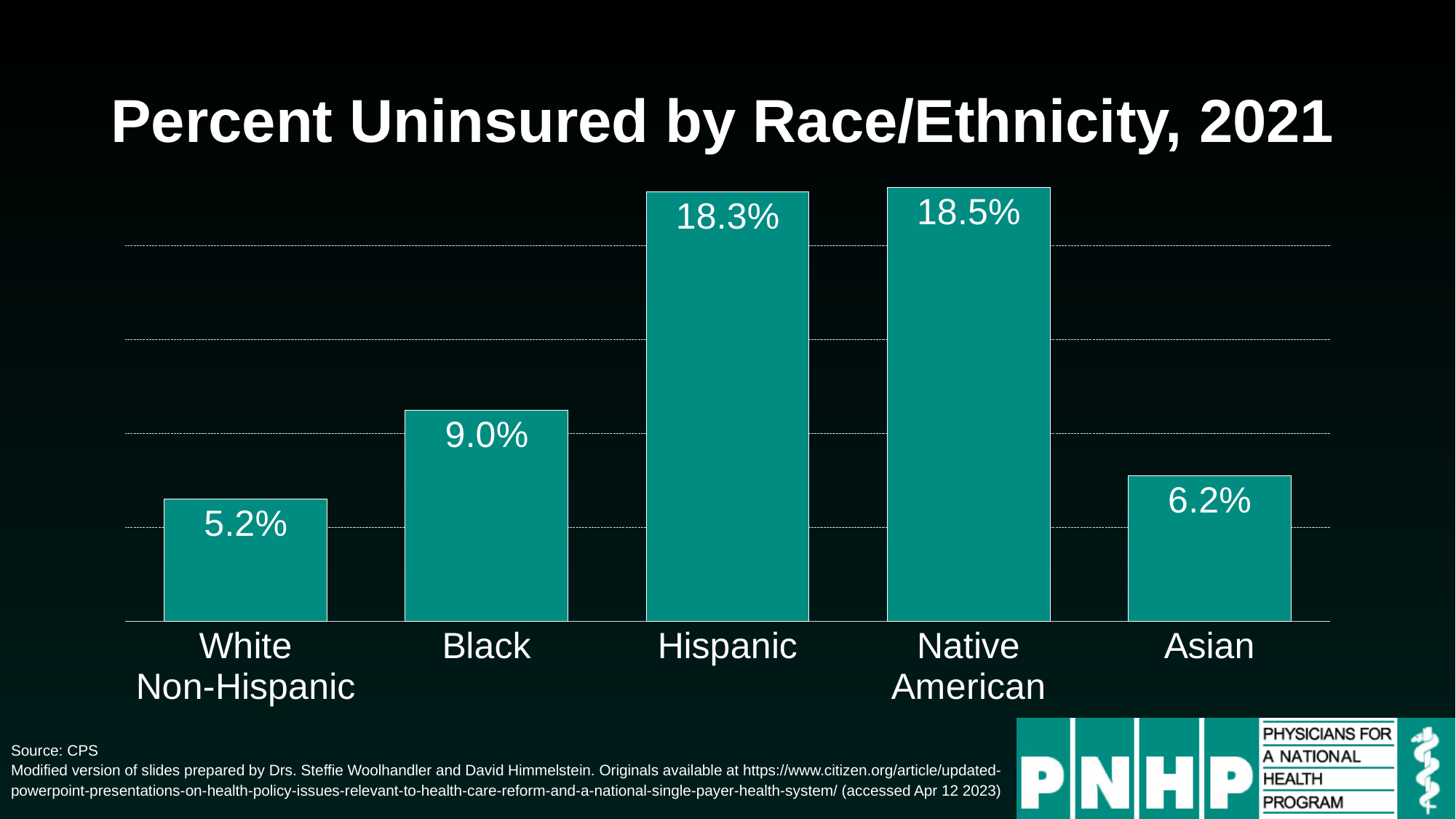
Which race/ethnicity has the lowest percent uninsured? White Non-Hispanic What is the title of the chart? Percent Uninsured by Race/Ethnicity, 2021 What is the percent uninsured for Black? 9.0% What is the percent uninsured for Asian? 6.2% What is the percent uninsured for Hispanic? 18.3% What kind of chart is shown on the slide? Bar chart Which race/ethnicity has the highest percent uninsured? Native American What is the difference in percent uninsured between Black and Asian? 2.8% How many race/ethnicity categories are shown in the chart? 5 What is the percent uninsured for White Non-Hispanic? 5.2% What is the difference in percent uninsured between Native American and White Non-Hispanic? 13.3% Which has a higher percent uninsured, Black or Asian? Black